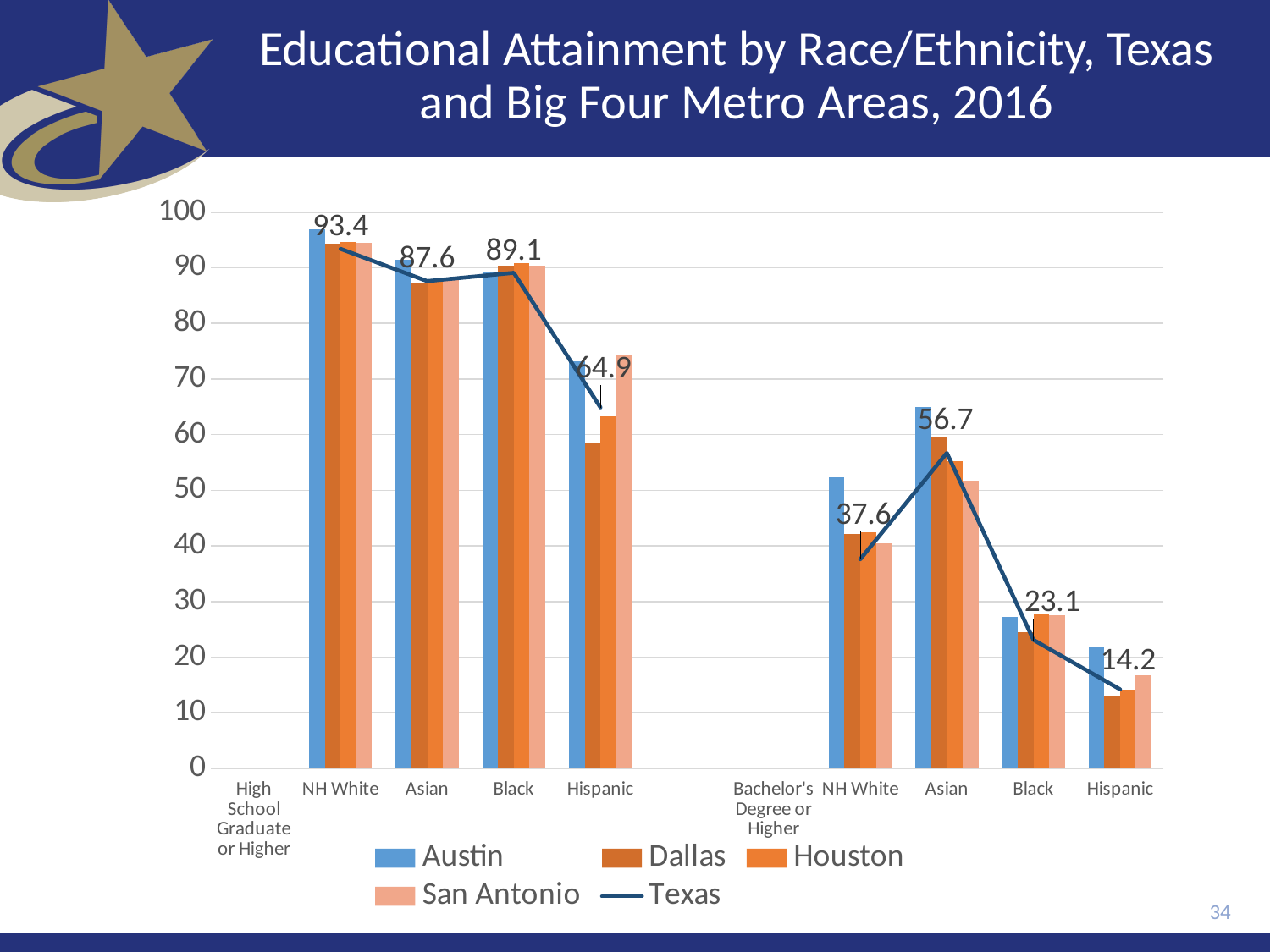
Among the labeled Texas values under High School Graduate or Higher, which race/ethnicity group is lowest? Hispanic What is the Texas value for Asian under Bachelor's Degree or Higher? 56.7 What is the Texas value for NH White under High School Graduate or Higher? 93.4 What is the difference between the Texas values for Asian and Black under Bachelor's Degree or Higher? 33.6 Under High School Graduate or Higher for Hispanic, which is larger, the Austin bar or the Dallas bar? Austin Among the labeled Texas values under Bachelor's Degree or Higher, which race/ethnicity group is highest? Asian What is the difference between the Texas values for NH White and Hispanic under High School Graduate or Higher? 28.5 What kind of chart is shown on the slide? Bar chart with a line How many series does the legend list? 5 Is the Dallas value for Hispanic under Bachelor's Degree or Higher greater or less than 20? less Is the Austin value for NH White under High School Graduate or Higher greater or less than 90? greater What is the Texas value for Hispanic under Bachelor's Degree or Higher? 14.2